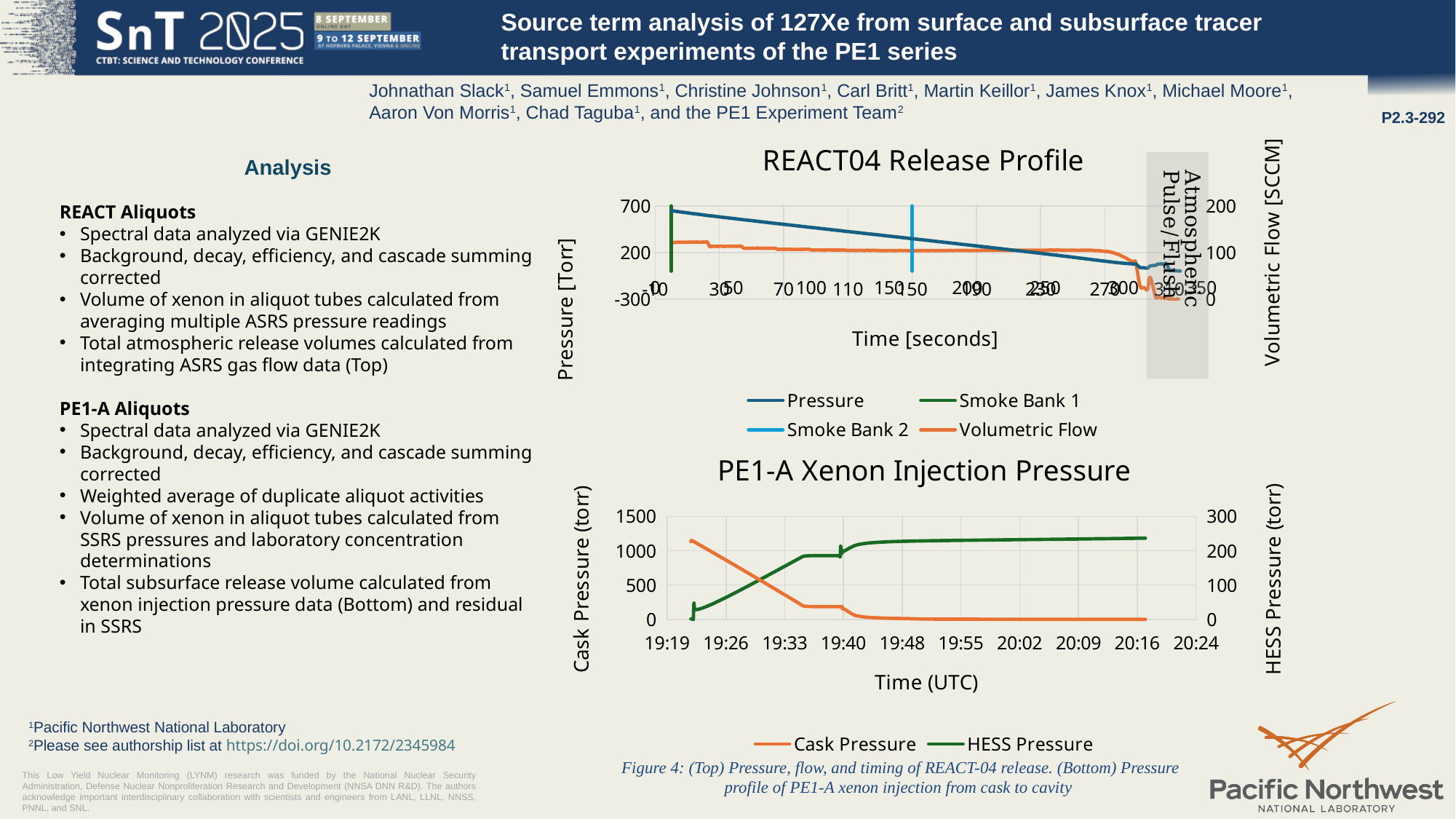
How many series does the legend of the REACT04 Release Profile chart list? 4 In the PE1-A Xenon Injection Pressure chart, does the Cask Pressure rise or fall over time? fall What is the right-hand y-axis label of the REACT04 Release Profile chart? Volumetric Flow [SCCM] In the PE1-A Xenon Injection Pressure chart, is the Cask Pressure at 19:19 greater or less than 1000 torr? greater In the PE1-A Xenon Injection Pressure chart, does the HESS Pressure rise or fall over time? rise How many series does the legend of the PE1-A Xenon Injection Pressure chart list? 2 In the REACT04 Release Profile chart, does the Pressure series rise or fall along the time axis? fall What type of chart is the PE1-A Xenon Injection Pressure chart? line chart In the PE1-A Xenon Injection Pressure chart, is the Cask Pressure at 20:16 greater or less than 500 torr? less What is the x-axis label of the PE1-A Xenon Injection Pressure chart? Time (UTC) In the PE1-A Xenon Injection Pressure chart, is the HESS Pressure at 20:16 greater or less than 200 torr? greater What type of chart is the REACT04 Release Profile? line chart